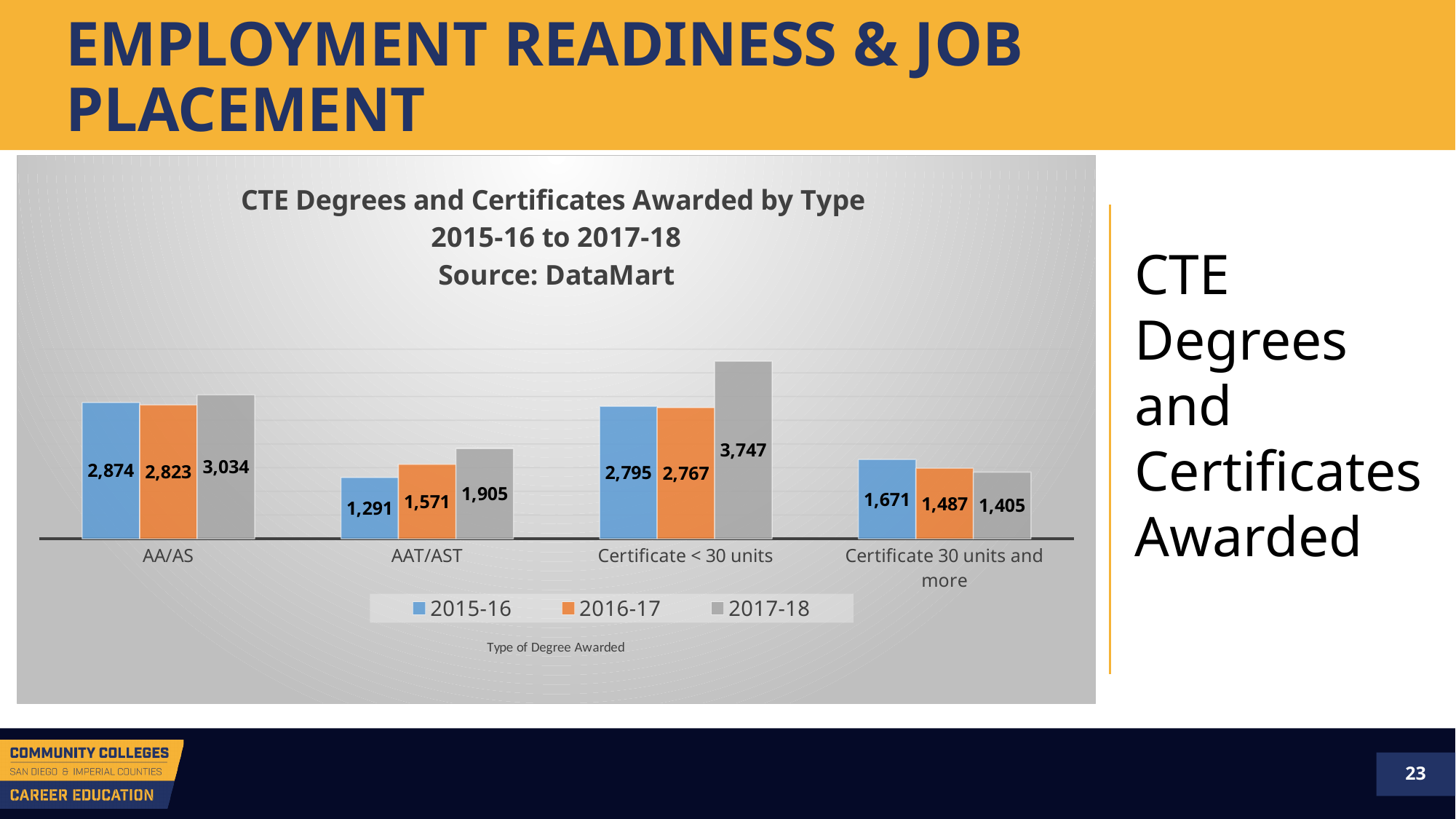
Which is larger for Certificate 30 units and more: the 2015-16 value or the 2017-18 value? 2015-16 How many types of degree are shown on the x axis? 4 What value is shown for AA/AS in 2017-18? 3,034 What value is shown for Certificate 30 units and more in 2016-17? 1,487 Which type of degree has the lowest value in 2015-16? AAT/AST What value is shown for AAT/AST in 2015-16? 1,291 Which type of degree has the highest value in 2017-18? Certificate < 30 units What value is shown for Certificate < 30 units in 2017-18? 3,747 What is the difference between the 2017-18 and 2015-16 values for AAT/AST? 614 What kind of chart is shown on the slide? Bar chart How many series does the legend list? 3 Do the values for Certificate 30 units and more rise or fall from 2015-16 to 2017-18? Fall